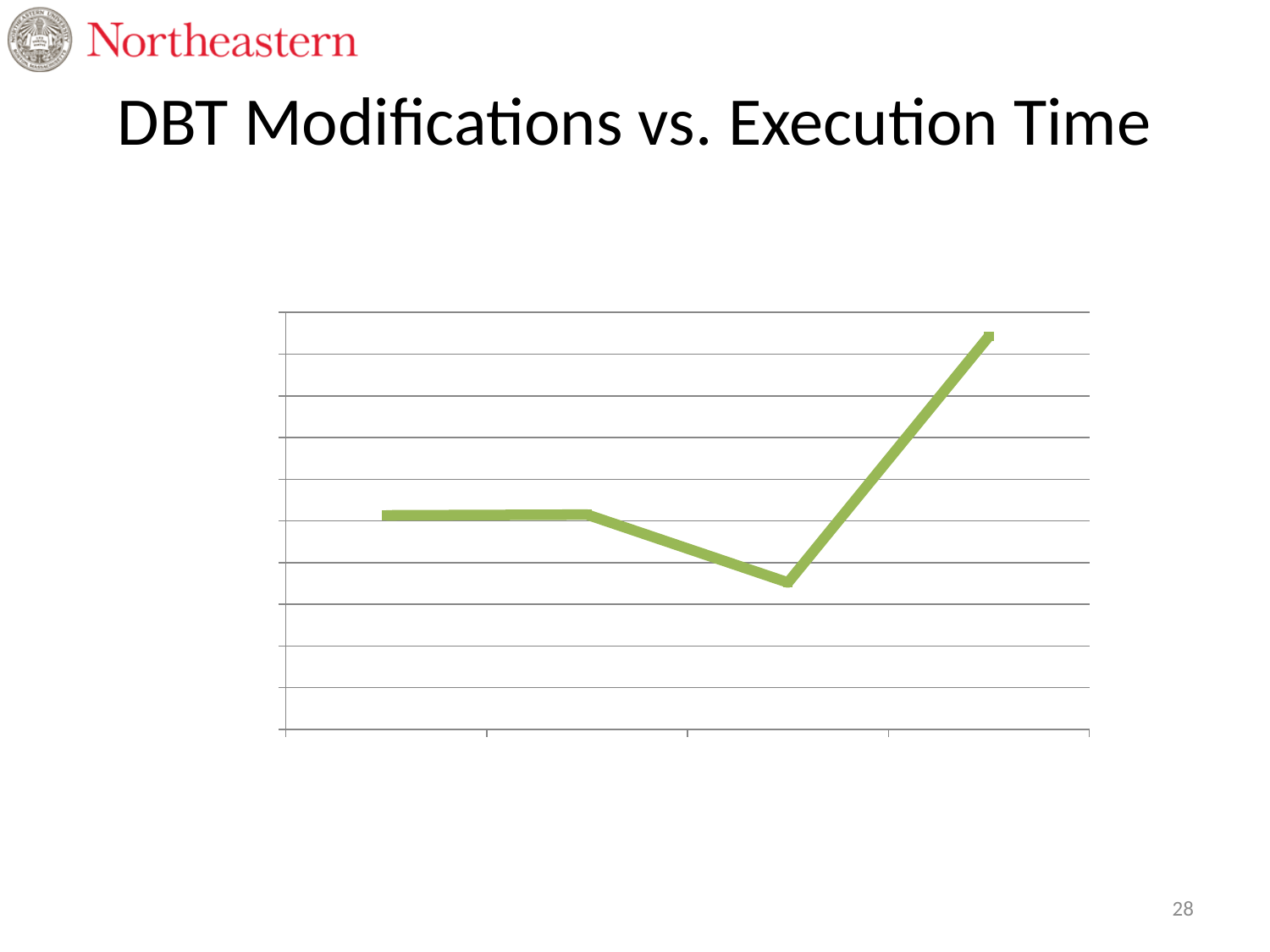
How many lines are plotted on the chart? 1 Does the line rise or fall between the second and third points? fall How many data points are plotted on the line? 4 Which data point on the line is the highest: the first, second, third, or fourth? fourth Is the fourth point on the line higher or lower than the first point? higher Does the line rise or fall between the third and fourth points? rise Which data point on the line is the lowest: the first, second, third, or fourth? third What colour is the plotted line? green What kind of chart is shown on the slide? line chart